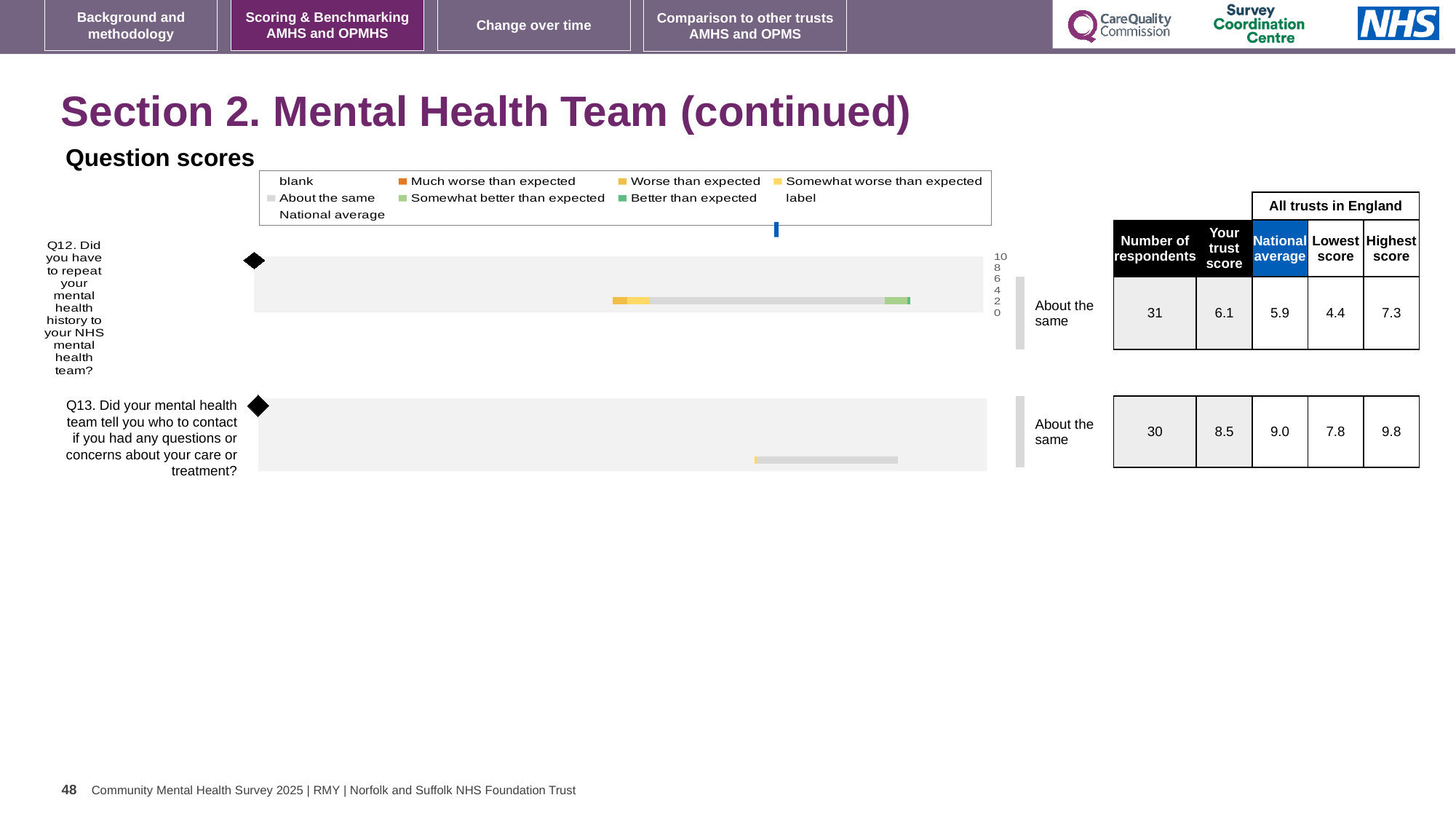
What is the difference between the national average and the trust score for Q13? 0.5 In the legend, which colour represents 'Much worse than expected'? orange What is the national average for Q13 (who to contact with questions or concerns)? 9.0 What category label is given to the trust's result for Q12? About the same How many entries does the legend above the question score charts list? 9 What is the highest score across all trusts in England for Q12? 7.3 How many respondents answered Q13? 30 What is the lowest score across all trusts in England for Q13? 7.8 What is the trust score for Q12 (repeating mental health history)? 6.1 Which is larger for Q12: the trust score or the national average? trust score What kind of chart is used to show the Q12 and Q13 question scores? bar chart What is the highest value shown on the axis of the Q12 chart? 10